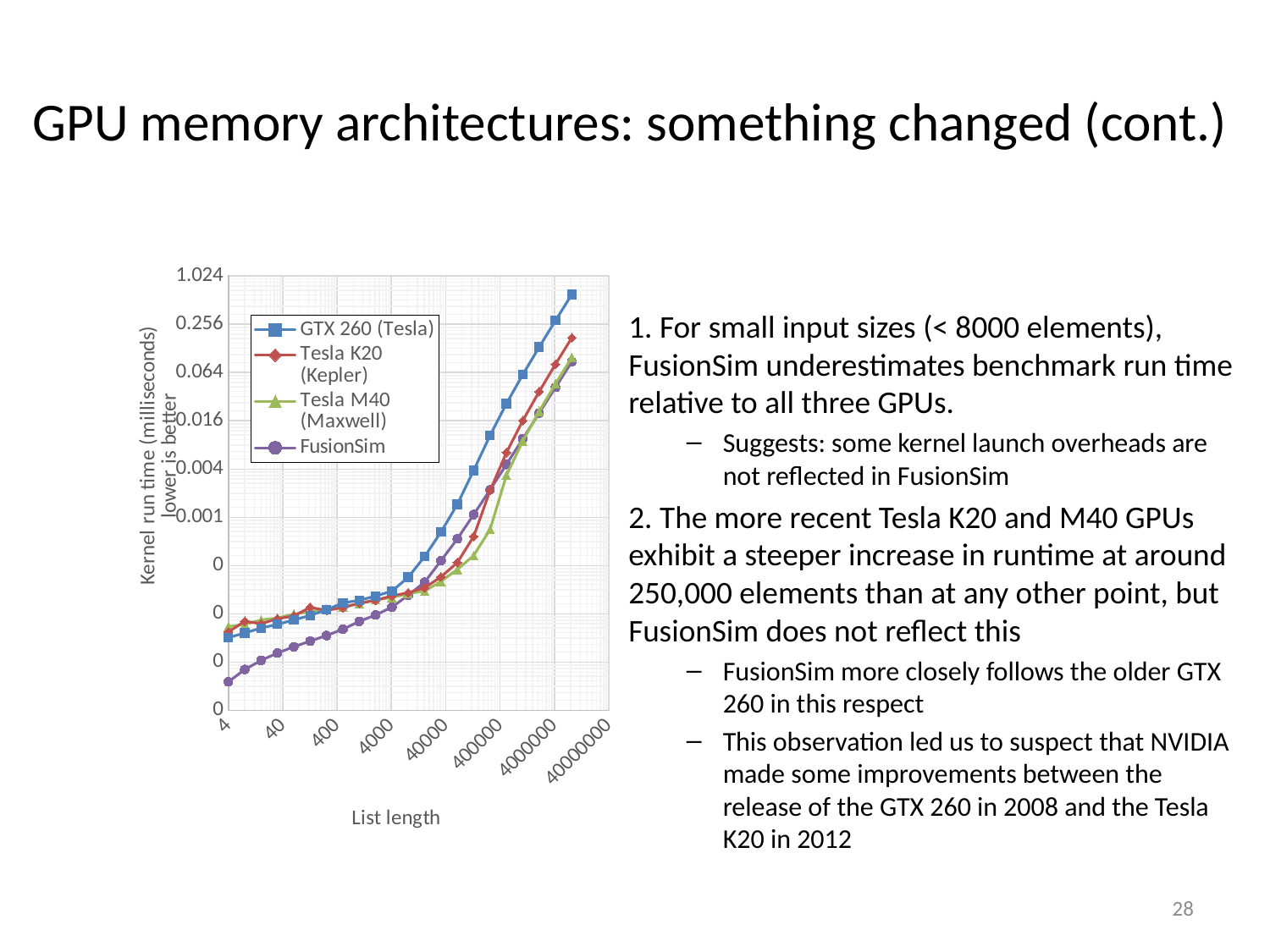
Is the FusionSim value at list length 4 greater or less than 0.001? less Do the kernel run times rise or fall as list length increases? rise Is the GTX 260 (Tesla) value at the largest list length greater or less than 0.256? greater What is the title of the x axis of the chart? List length What kind of chart is shown on the slide? line chart At list length 4, which has the larger kernel run time: GTX 260 (Tesla) or FusionSim? GTX 260 (Tesla) How many series does the chart legend list? 4 Which series are listed in the chart legend? GTX 260 (Tesla), Tesla K20 (Kepler), Tesla M40 (Maxwell), FusionSim Is the Tesla K20 (Kepler) value at the largest list length greater or less than 0.256? less Which series has the highest kernel run time at the largest list length? GTX 260 (Tesla) Which series has the lowest kernel run time at list length 4? FusionSim How many list length tick labels are shown on the x axis? 8